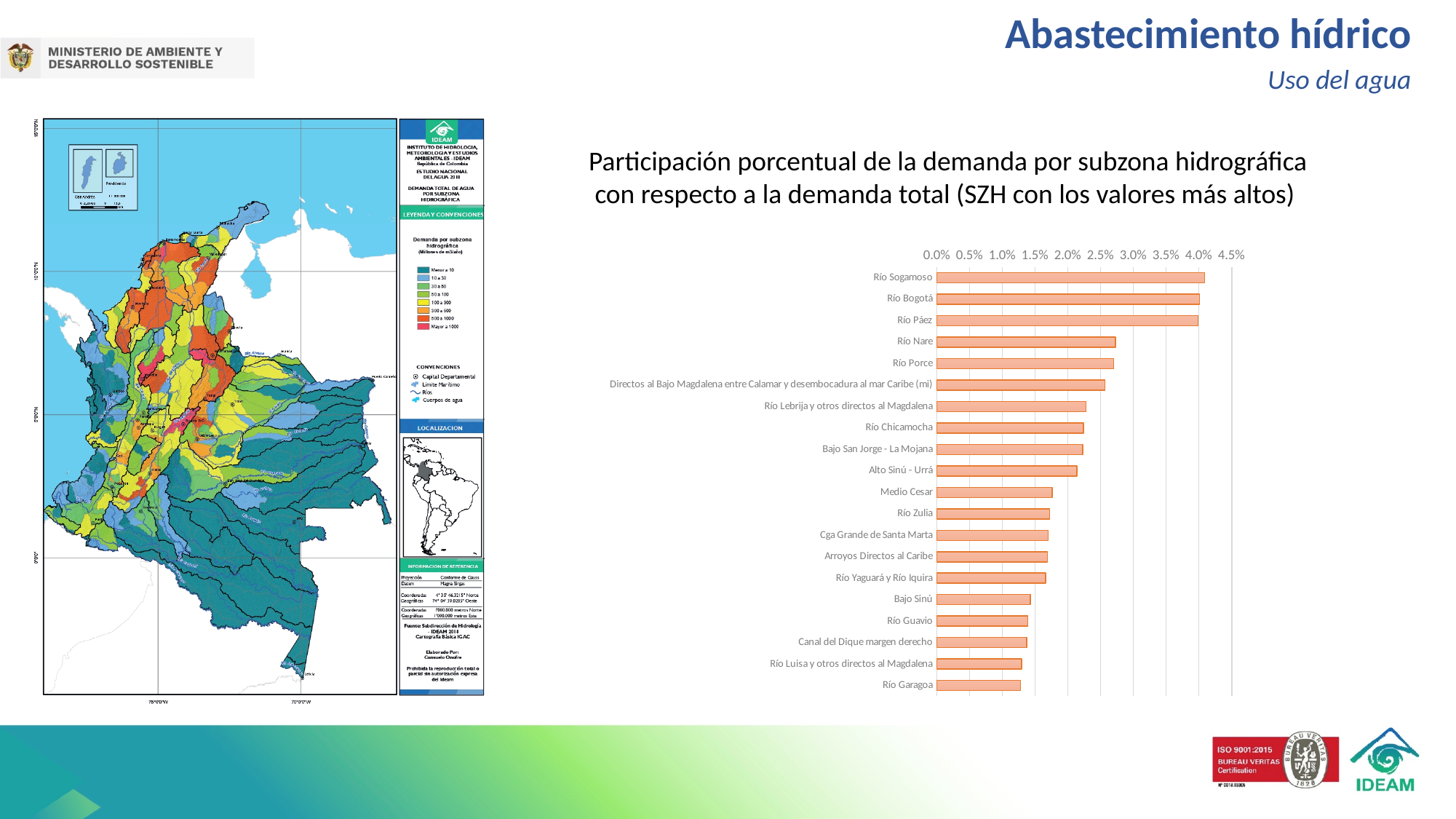
What kind of chart is shown on the slide? Bar chart Which subzona hidrográfica has the highest share of total demand in the chart? Río Sogamoso Is the value for Río Garagoa greater or less than 1.5%? less Is the value for Río Sogamoso greater or less than 3.5%? greater What is the highest percentage tick shown on the chart's axis? 4.5% Which has a larger share of total demand, Río Páez or Río Porce? Río Páez Do the bar values increase or decrease going from the top category to the bottom category of the chart? decrease How many subzonas hidrográficas (categories) are plotted in the bar chart? 20 Is the value for Medio Cesar greater or less than 2.0%? less Which has a larger share of total demand, Río Nare or Río Garagoa? Río Nare